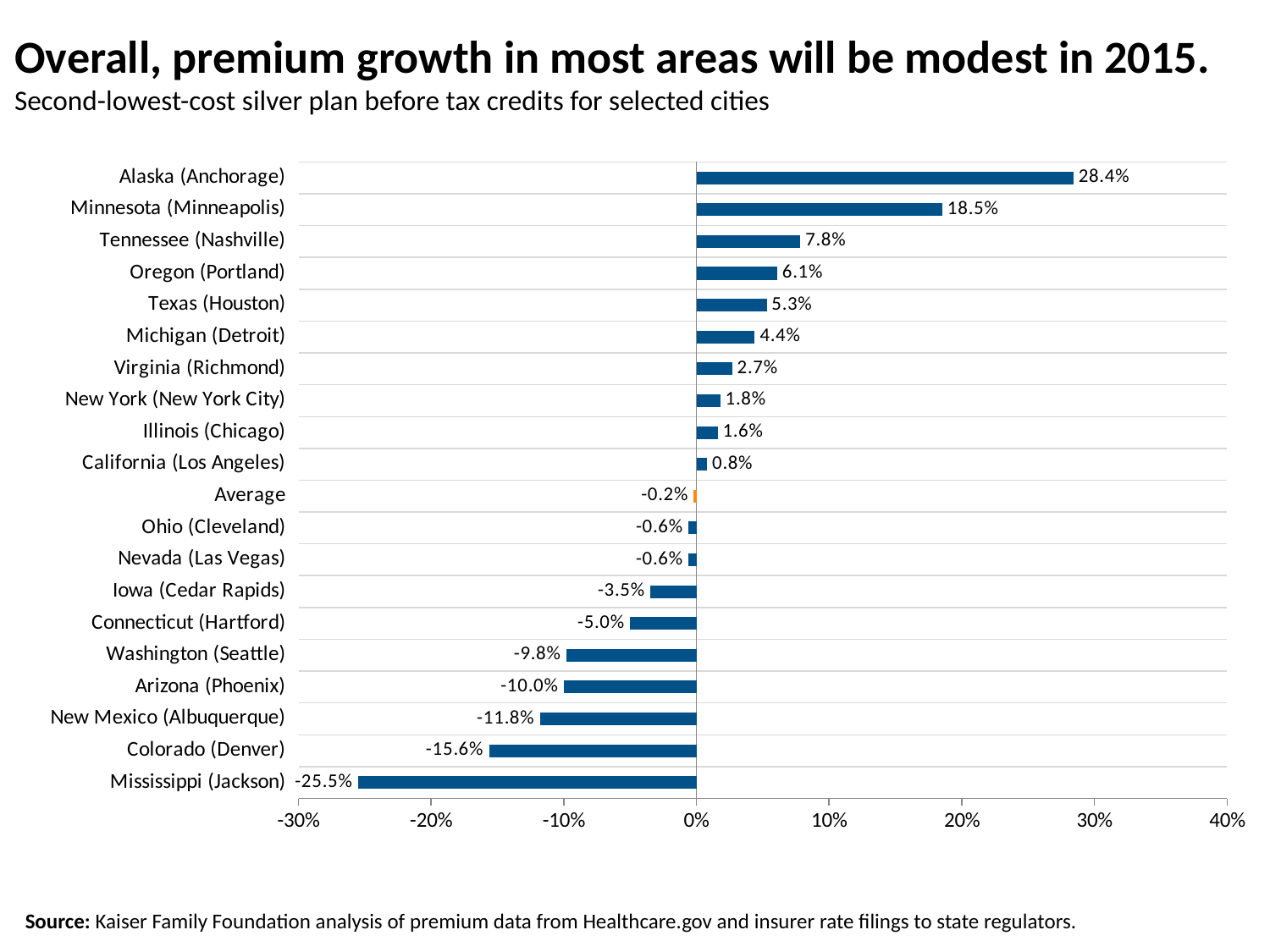
What is the value shown for the Average bar? -0.2% What is the value shown for Colorado (Denver)? -15.6% Which city has the lowest premium growth? Mississippi (Jackson) Which city has the highest premium growth? Alaska (Anchorage) What kind of chart is shown on the slide? Bar chart What is the premium growth value for Alaska (Anchorage)? 28.4% Which has a larger value, Texas (Houston) or Michigan (Detroit)? Texas (Houston) What is the difference between the values for Alaska (Anchorage) and Minnesota (Minneapolis)? 9.9% What is the value shown for New Mexico (Albuquerque)? -11.8% How many categories (bars) are shown in the chart? 20 Is the value for Minnesota (Minneapolis) greater or less than 10%? greater Which bar is shown in a different colour (orange) from the others? Average